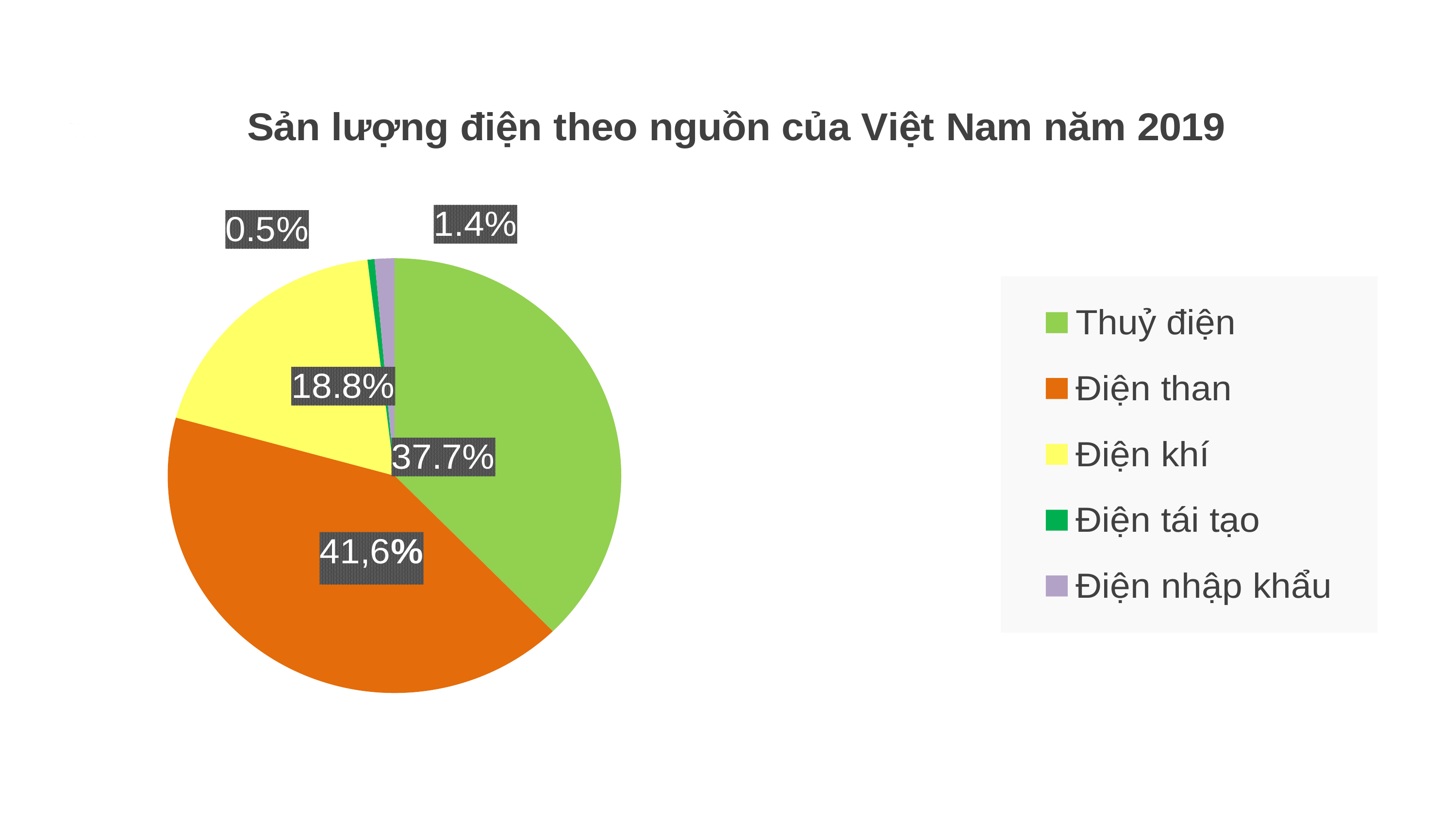
What is the difference between the shares of Thuỷ điện and Điện khí? 18.9% What percentage share does Điện tái tạo have in the pie chart? 0.5% What is the title of the chart? Sản lượng điện theo nguồn của Việt Nam năm 2019 What type of chart is shown on the slide? pie chart How many sources (slices) does the pie chart show? 5 Which has a larger share, Điện khí or Điện nhập khẩu? Điện khí Which source has the smallest share of the pie chart? Điện tái tạo What percentage share does Điện than have in the pie chart? 41,6% What percentage share does Thuỷ điện have in the pie chart? 37.7% What percentage share does Điện khí have in the pie chart? 18.8% What percentage share does Điện nhập khẩu have in the pie chart? 1.4% Which source has the largest share of the pie chart? Điện than